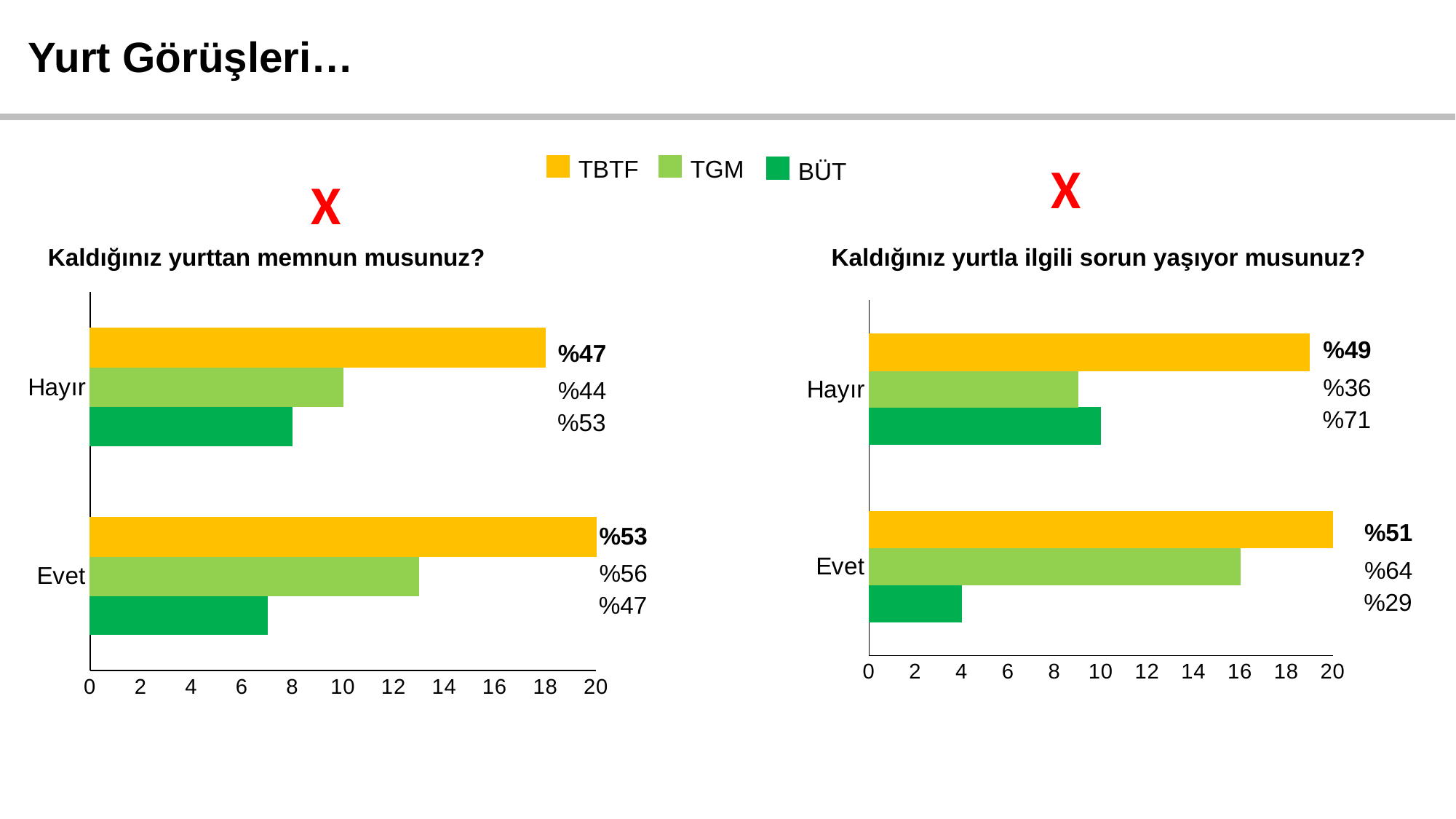
How many series does the legend on the slide list? 3 In the chart titled "Kaldığınız yurttan memnun musunuz?", what is the TBTF value for Hayır? %47 In the chart titled "Kaldığınız yurttan memnun musunuz?", what is the difference between the TGM and BÜT labelled values for Evet? 9 percentage points In the chart titled "Kaldığınız yurttan memnun musunuz?", what is the TGM value for Evet? %56 In the chart titled "Kaldığınız yurtla ilgili sorun yaşıyor musunuz?", what is the BÜT value for Hayır? %71 In the chart titled "Kaldığınız yurtla ilgili sorun yaşıyor musunuz?", what is the TGM value for Evet? %64 What kind of chart is the chart titled "Kaldığınız yurtla ilgili sorun yaşıyor musunuz?"? Bar chart In the chart titled "Kaldığınız yurtla ilgili sorun yaşıyor musunuz?", which series has the lowest labelled value for Evet? BÜT In the chart titled "Kaldığınız yurttan memnun musunuz?", which is larger for Evet: the TGM value or the BÜT value? TGM In the chart titled "Kaldığınız yurtla ilgili sorun yaşıyor musunuz?", which series has the highest labelled value for Hayır? BÜT In the chart titled "Kaldığınız yurtla ilgili sorun yaşıyor musunuz?", what is the difference between the BÜT and TGM labelled values for Hayır? 35 percentage points How many categories does the chart titled "Kaldığınız yurttan memnun musunuz?" show? 2